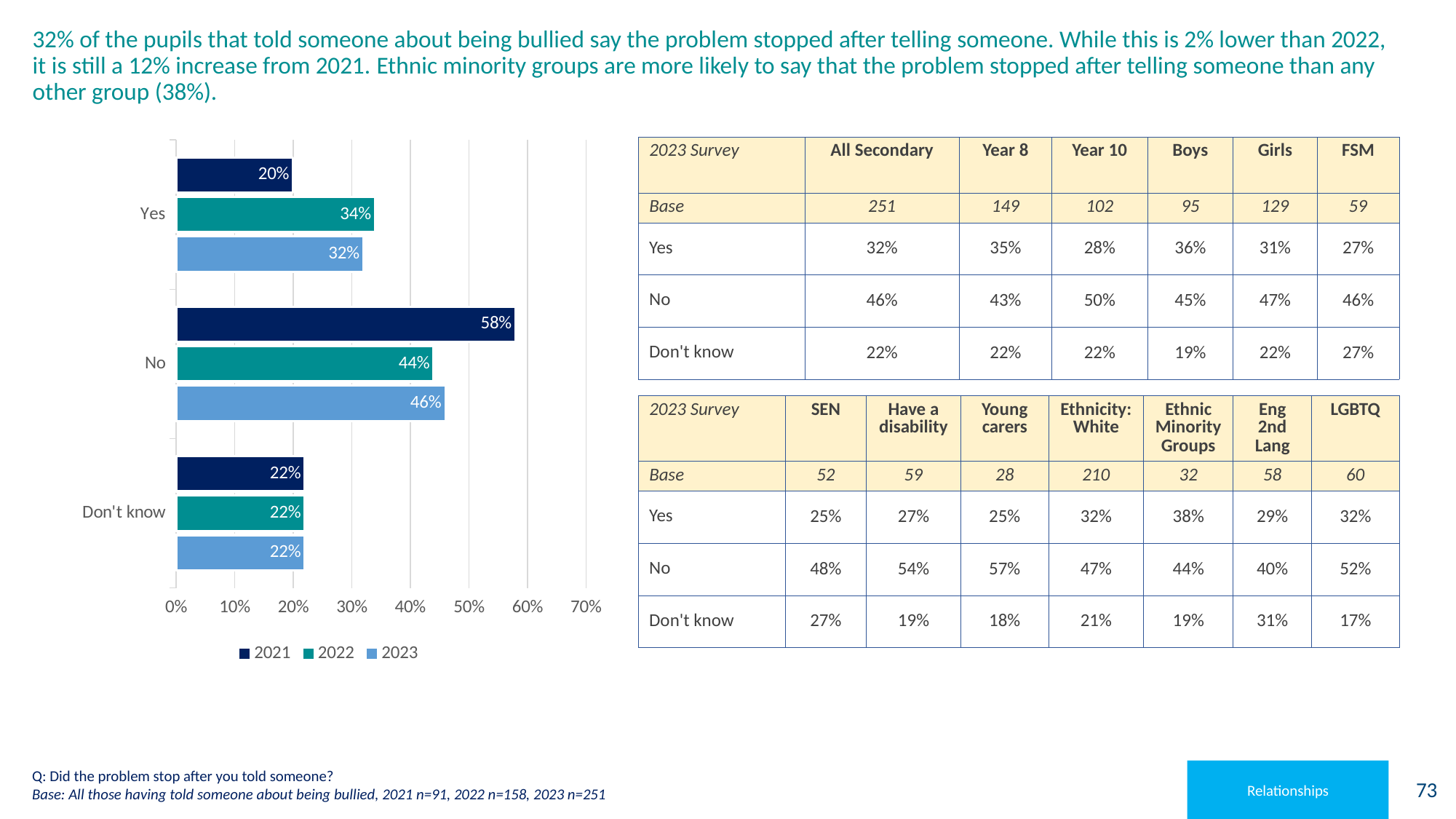
Which is larger for 'Yes': the 2022 value or the 2023 value? 2022 How many categories are shown on the chart? 3 What kind of chart is shown on the slide? Bar chart What is the value for 'Don't know' in the 2022 series? 22% Which category has the lowest value in the 2022 series? Don't know How many series does the legend list? 3 What is the difference between the 2021 and 2022 values for 'No'? 14% Which category has the highest value in the 2021 series? No Which series is shown in the darkest blue colour in the legend? 2021 What is the value for 'No' in the 2023 series? 46% What is the difference between the 2022 and 2023 values for 'Yes'? 2% What is the value for 'Yes' in the 2021 series? 20%